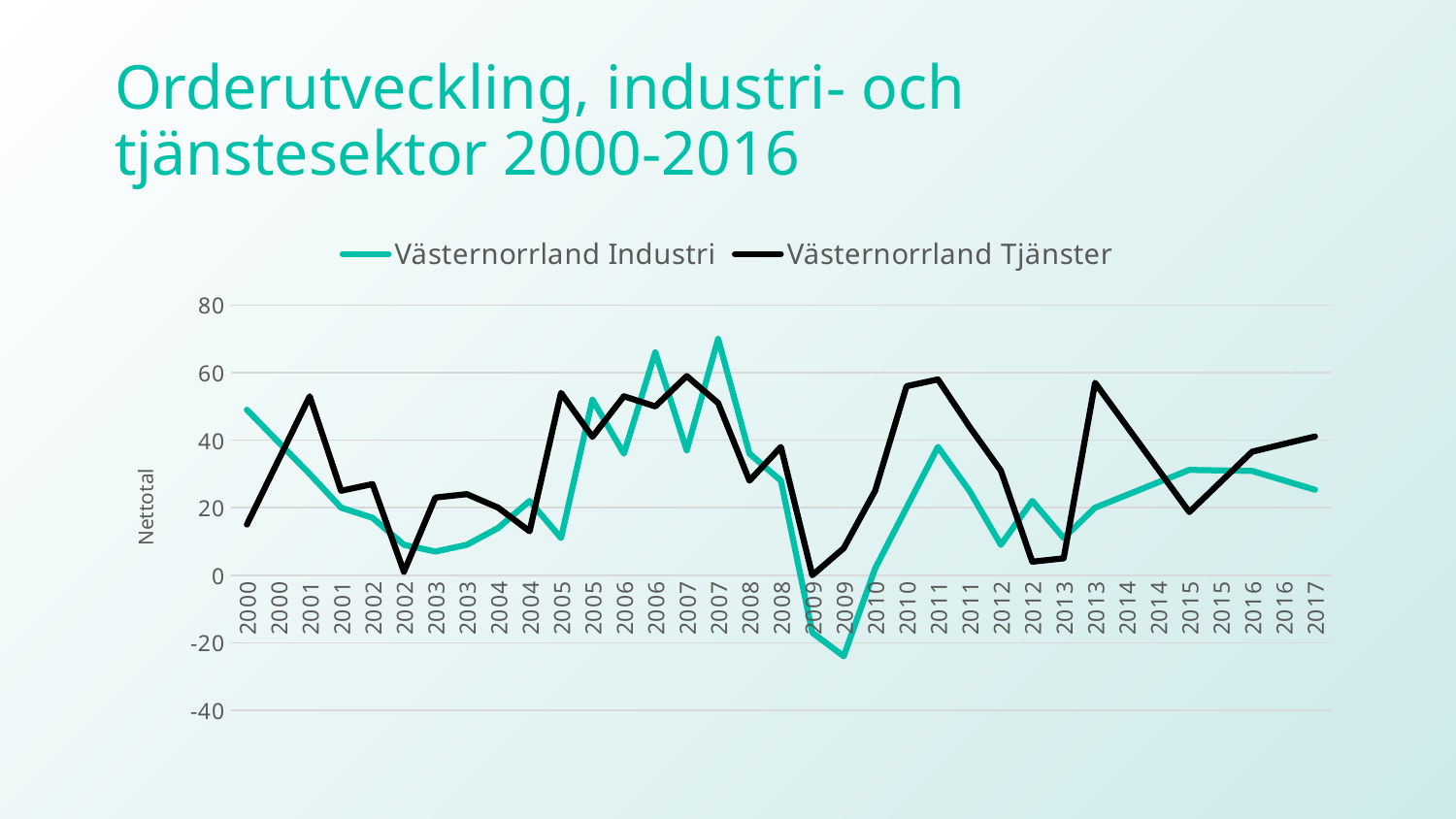
What is the label on the vertical axis? Nettotal Is the value for Västernorrland Industri at the second 2009 point greater or less than 0? less Is the value for Västernorrland Industri at the second 2007 point greater or less than 60? greater At which x-axis point does Västernorrland Industri reach its lowest value? the second 2009 point How many series does the legend list? 2 At which x-axis point does Västernorrland Industri reach its highest value? the second 2007 point What kind of chart is shown on the slide? line chart Is the value for Västernorrland Industri at the first 2000 point greater or less than 40? greater What are the two series named in the legend? Västernorrland Industri and Västernorrland Tjänster At the first 2013 point, which series has the larger value, Västernorrland Industri or Västernorrland Tjänster? Västernorrland Industri